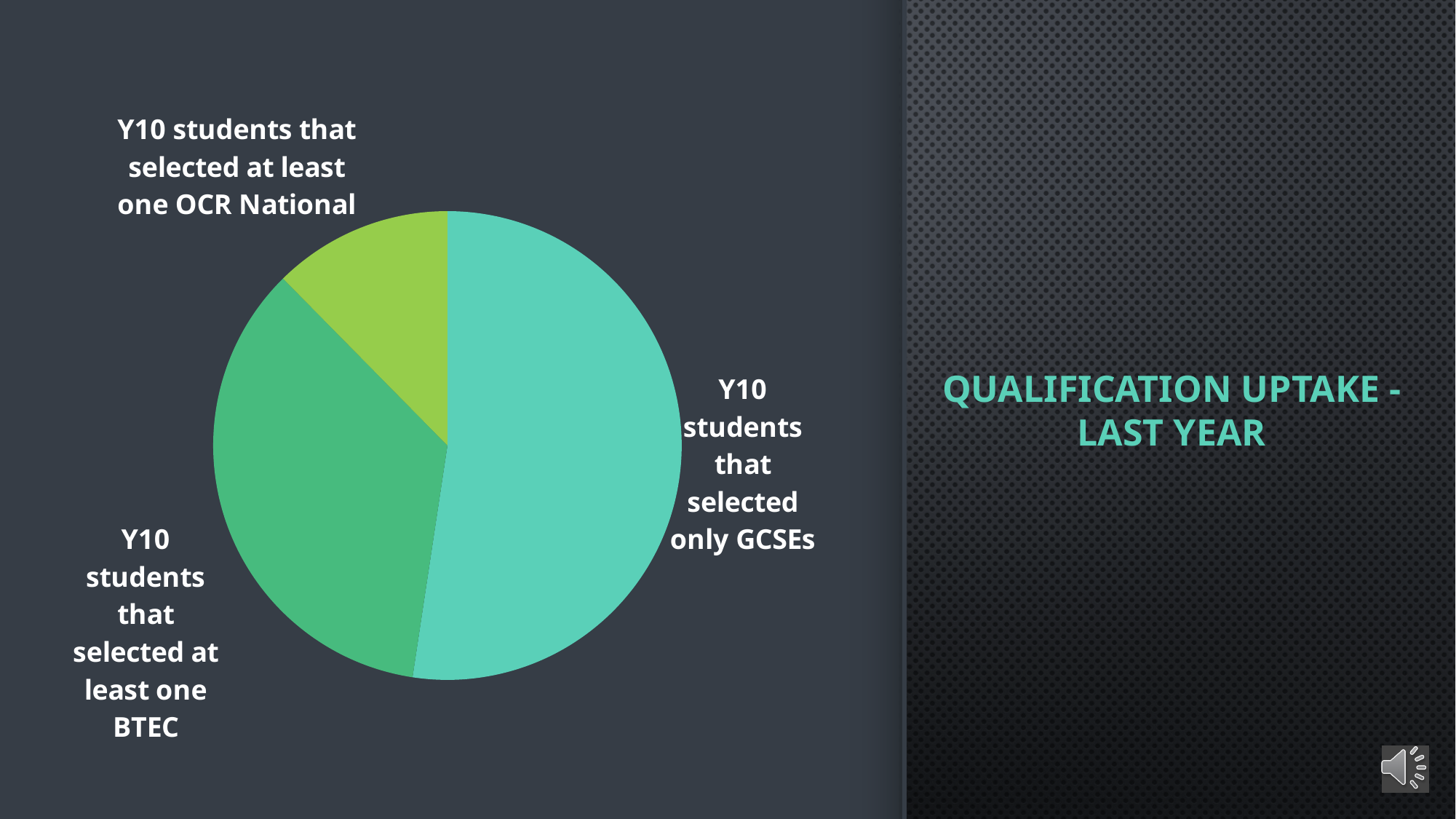
Which category is shown in the yellow-green slice of the pie chart? Y10 students that selected at least one OCR National What kind of chart is shown on the slide? pie chart Which category has the largest slice of the pie chart? Y10 students that selected only GCSEs Which slice is larger: Y10 students that selected at least one BTEC or Y10 students that selected at least one OCR National? Y10 students that selected at least one BTEC How many slices does the pie chart have? 3 What is the title shown on the slide for this chart? QUALIFICATION UPTAKE - LAST YEAR Which category has the smallest slice of the pie chart? Y10 students that selected at least one OCR National Which slice is larger: Y10 students that selected only GCSEs or Y10 students that selected at least one BTEC? Y10 students that selected only GCSEs